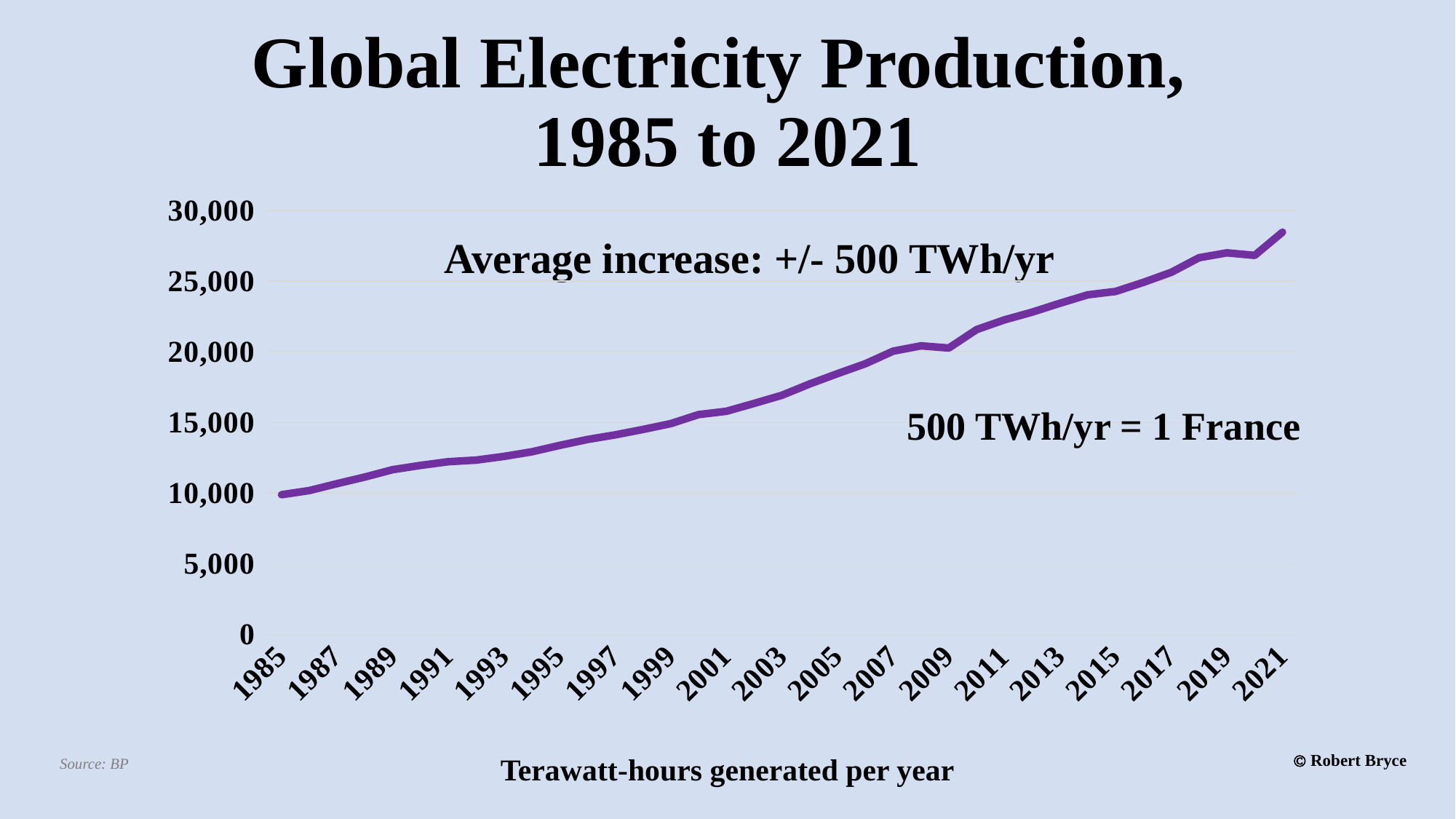
Is the value for 2021 greater or less than 25,000? greater Do the values generally rise or fall from 1985 to 2021? rise Which year has the larger value, 1985 or 2021? 2021 Is the value for 2019 greater or less than 25,000? greater Is the value for 2011 greater or less than 20,000? greater How many year labels are shown on the x axis? 19 According to the annotation on the chart, what is the average yearly increase? +/- 500 TWh/yr Which year has the lowest value on the chart? 1985 What kind of chart is shown on the slide? line chart What is the title of the chart? Global Electricity Production, 1985 to 2021 Which year has the highest value on the chart? 2021